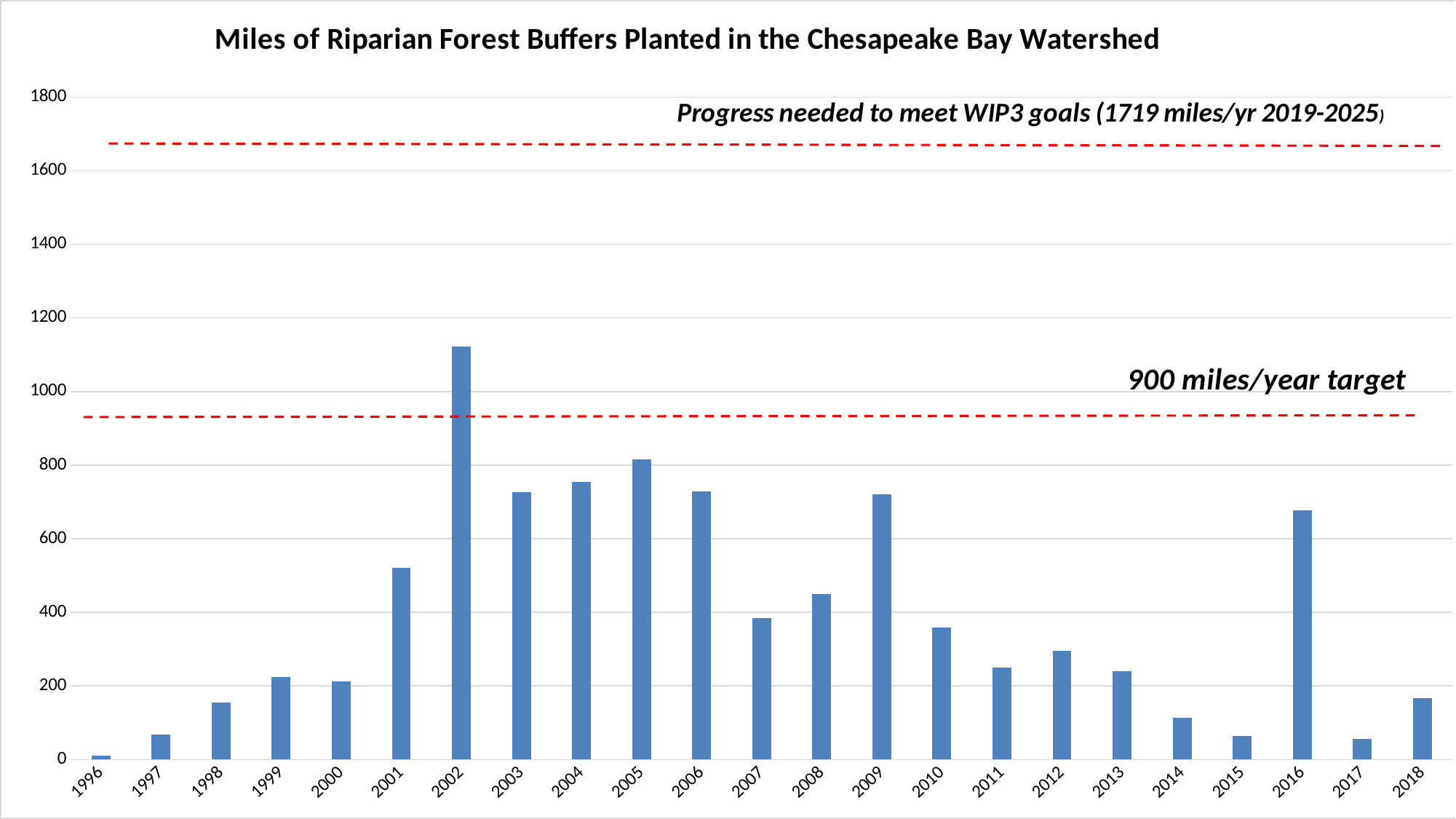
Which year has the lowest number of miles of riparian forest buffers planted? 1996 Is the value for 2016 greater or less than 600? greater Which year has the larger value, 2009 or 2010? 2009 Is the value for 2001 greater or less than 400? greater Is the value for 2002 greater or less than 1000? greater What is the title of the chart? Miles of Riparian Forest Buffers Planted in the Chesapeake Bay Watershed What kind of chart is shown on the slide? bar chart According to the label on the upper dashed line, how many miles per year are needed to meet WIP3 goals for 2019-2025? 1719 miles/yr Do the values rise or fall from 1996 to 2002? rise How many years are plotted on the x axis of the chart? 23 Which year has the highest number of miles of riparian forest buffers planted? 2002